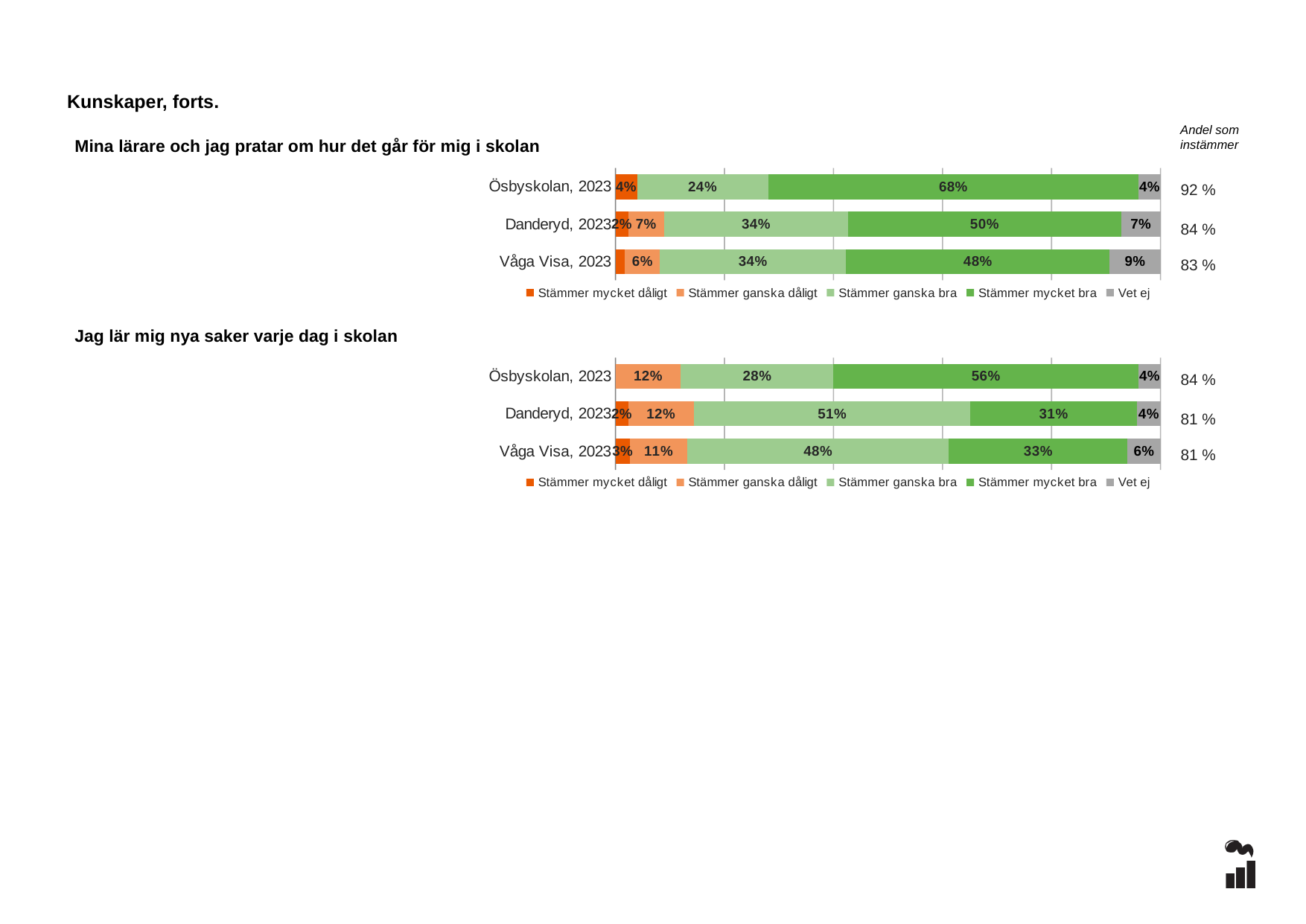
In the chart 'Mina lärare och jag pratar om hur det går för mig i skolan', which row has the highest 'Stämmer mycket bra' share? Ösbyskolan, 2023 In the chart 'Jag lär mig nya saker varje dag i skolan', which row has the lowest 'Stämmer mycket bra' share? Danderyd, 2023 How many series does the legend of the chart 'Jag lär mig nya saker varje dag i skolan' list? 5 In the chart 'Mina lärare och jag pratar om hur det går för mig i skolan', what percentage of Ösbyskolan, 2023 answered 'Stämmer mycket bra'? 68% In the chart 'Jag lär mig nya saker varje dag i skolan', what is the 'Stämmer mycket bra' value for Våga Visa, 2023? 33% In the chart 'Mina lärare och jag pratar om hur det går för mig i skolan', what is the 'Vet ej' value for Våga Visa, 2023? 9% In the chart 'Mina lärare och jag pratar om hur det går för mig i skolan', what is the 'Andel som instämmer' for Ösbyskolan, 2023? 92 % In the chart 'Mina lärare och jag pratar om hur det går för mig i skolan', what is the 'Stämmer ganska bra' value for Danderyd, 2023? 34% In the chart 'Jag lär mig nya saker varje dag i skolan', is the 'Stämmer ganska bra' share larger for Ösbyskolan, 2023 or for Våga Visa, 2023? Våga Visa, 2023 In the chart 'Mina lärare och jag pratar om hur det går för mig i skolan', how much larger is the 'Stämmer mycket bra' share for Ösbyskolan, 2023 than for Våga Visa, 2023? 20 percentage points In the chart 'Jag lär mig nya saker varje dag i skolan', what is the 'Stämmer ganska bra' value for Danderyd, 2023? 51% What kind of chart is used for 'Mina lärare och jag pratar om hur det går för mig i skolan'? Stacked bar chart